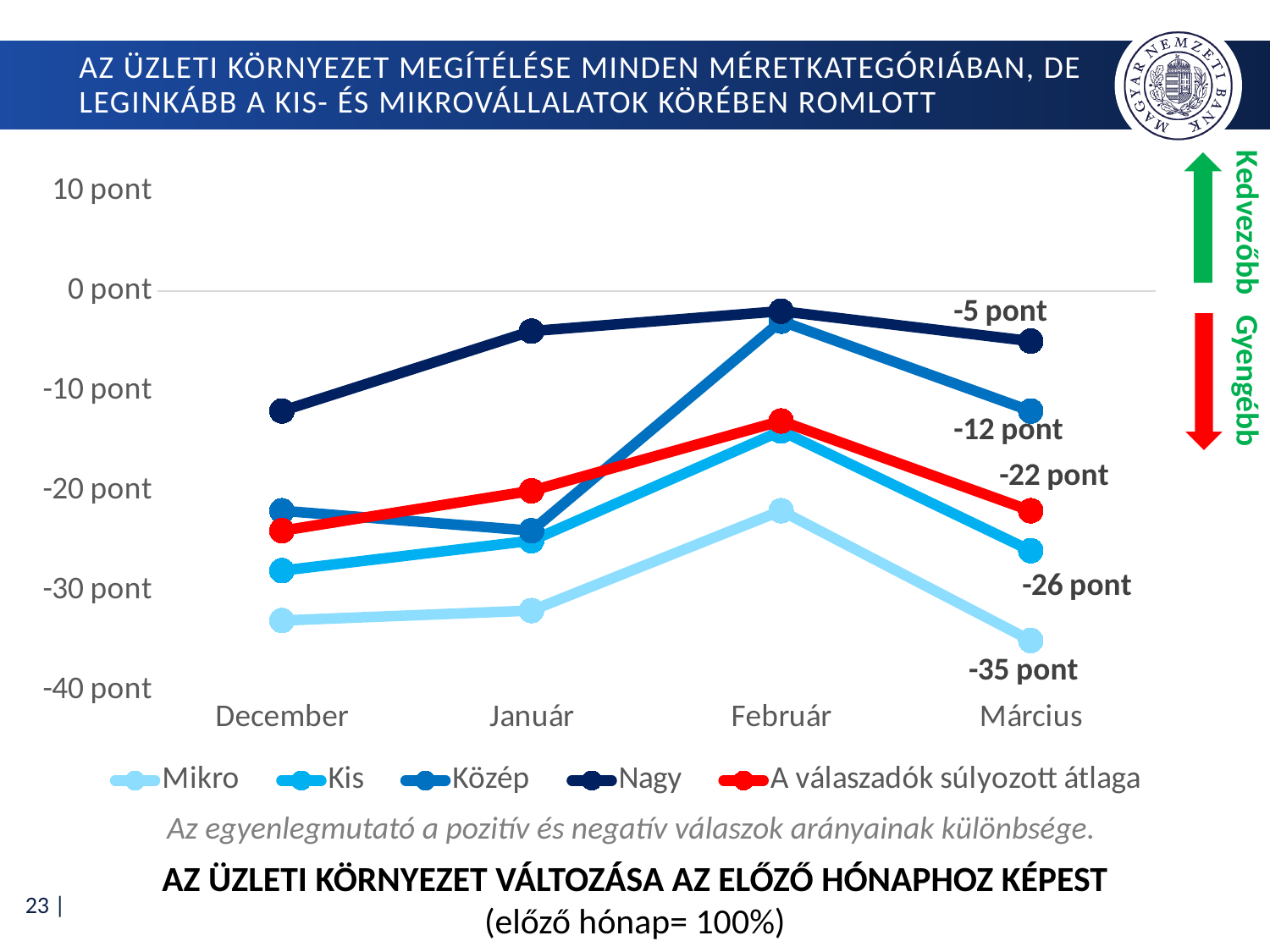
How many months are shown on the x axis? 4 Which series has the lowest value in Március? Mikro What is the value for Mikro in Március? -35 pont In Március, which is larger: the value for Közép or the value for Kis? Közép How many series does the legend list? 5 What is the value for Nagy in Március? -5 pont What is the value for A válaszadók súlyozott átlaga in Március? -22 pont Is the value for Mikro in December greater or less than -30 pont? less What kind of chart is shown on the slide? line chart Does the Mikro series rise or fall from Február to Március? fall What is the difference between the Nagy and Mikro values in Március? 30 pont Which series has the highest value in Március? Nagy